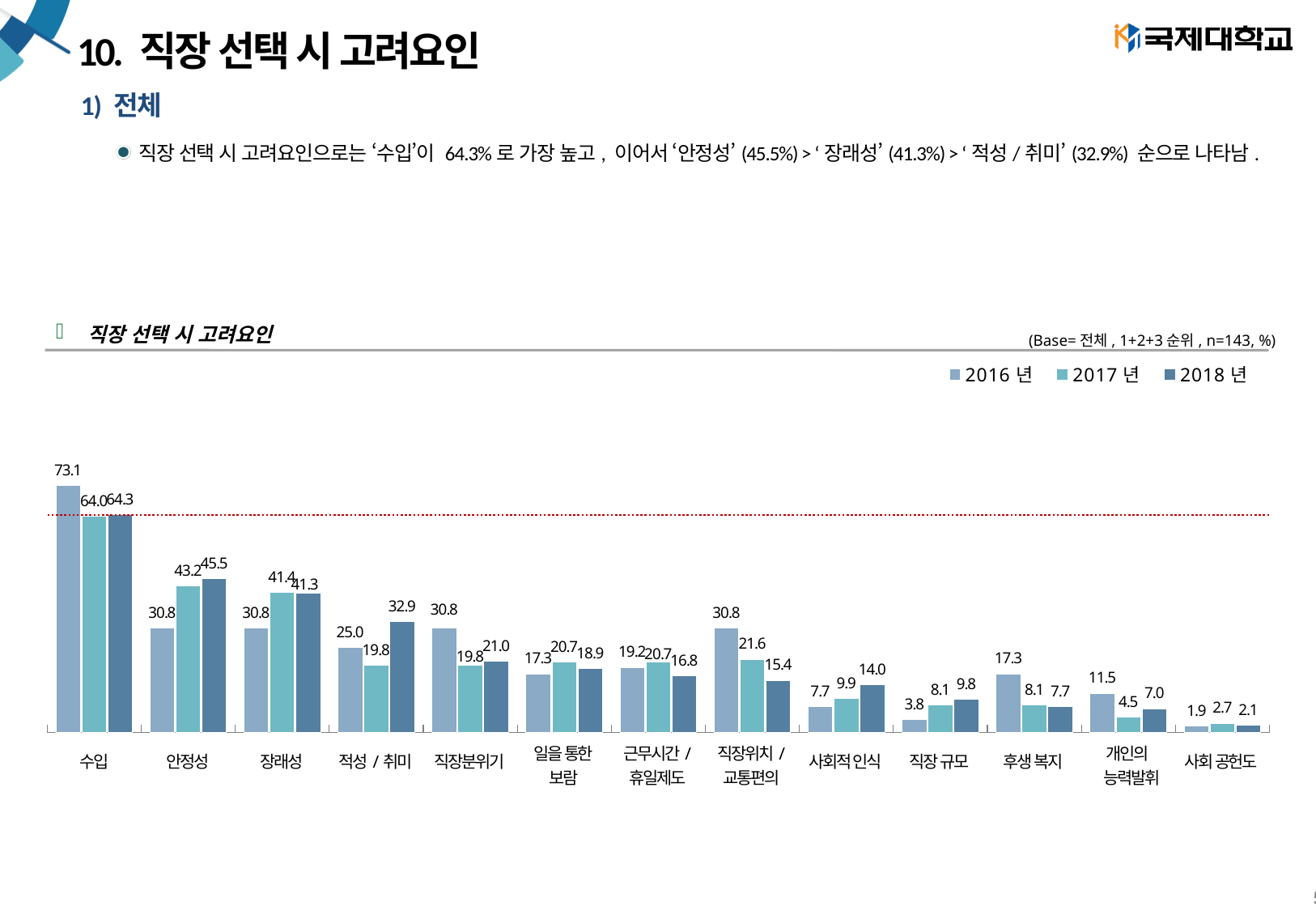
What kind of chart is shown on the slide? bar chart Which category has the lowest 2016년 value? 사회 공헌도 Which is larger for 적성 / 취미: the 2016년 value or the 2018년 value? 2018년 Which category has the highest 2018년 value? 수입 Do the 2018년 values for 사회적 인식 rise or fall from 2016년 to 2018년? rise How many categories are shown on the x axis? 13 What is the 2018년 value for 수입? 64.3 What is the title of the chart? 직장 선택 시 고려요인 How many series does the legend list? 3 What is the 2017년 value for 직장위치 / 교통편의? 21.6 What is the difference between the 2016년 and 2018년 values for 수입? 8.8 What is the 2016년 value for 안정성? 30.8